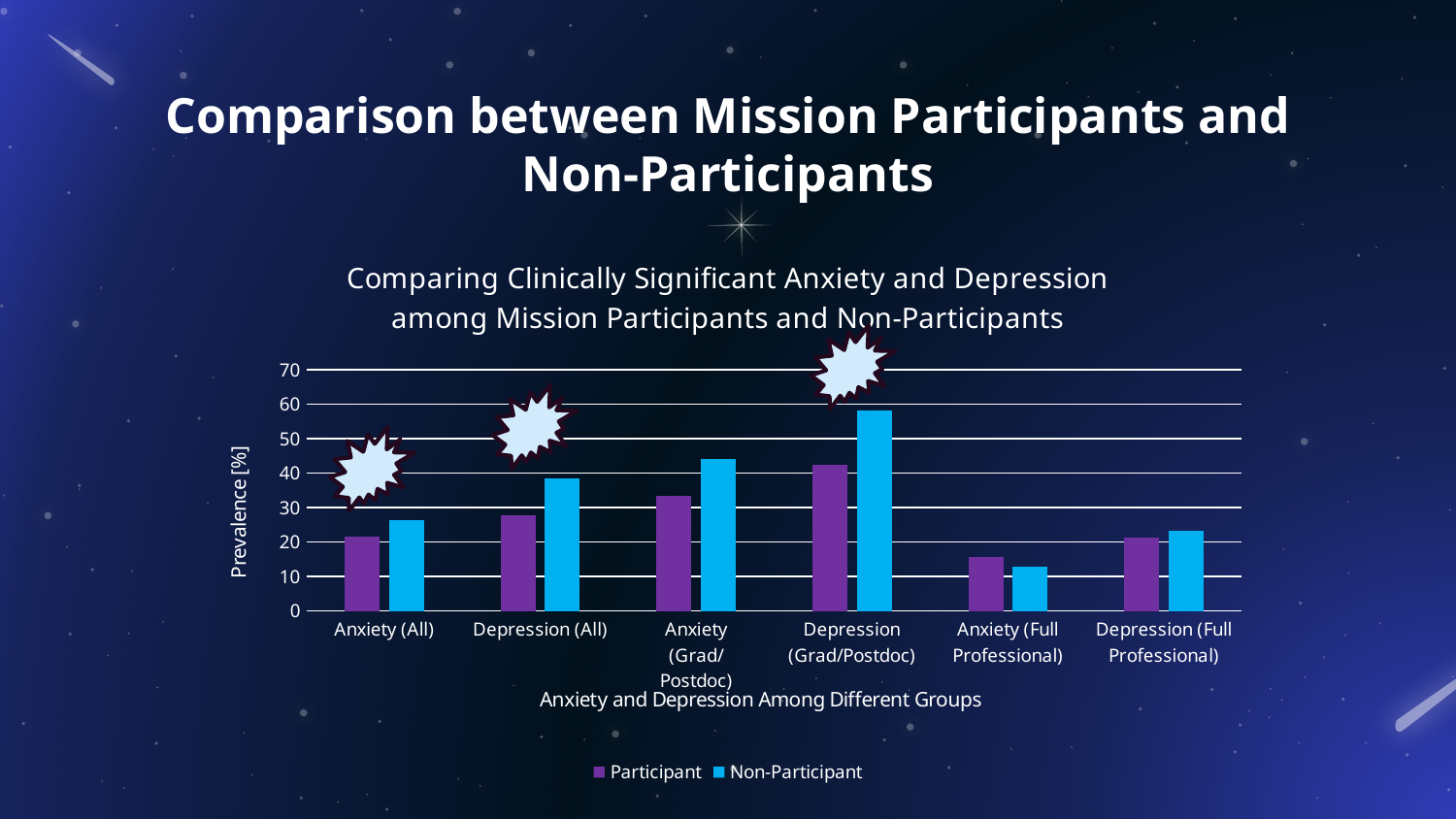
Is the Non-Participant value for Anxiety (Grad/Postdoc) greater or less than 50? less Which group and series has the highest bar in the chart? Non-Participant, Depression (Grad/Postdoc) Is the Participant value for Anxiety (Full Professional) greater or less than 20? less For Anxiety (Grad/Postdoc), which is larger: the Participant or the Non-Participant value? Non-Participant How many series does the chart legend list? 2 For Depression (All), which is larger: the Participant or the Non-Participant value? Non-Participant How many groups are shown along the x axis of the chart? 6 Is the Non-Participant value for Anxiety (All) greater or less than 20? greater What kind of chart is shown on the slide? Bar chart Among the Participant bars, which group has the lowest value? Anxiety (Full Professional) What is the label of the chart's vertical axis? Prevalence [%]